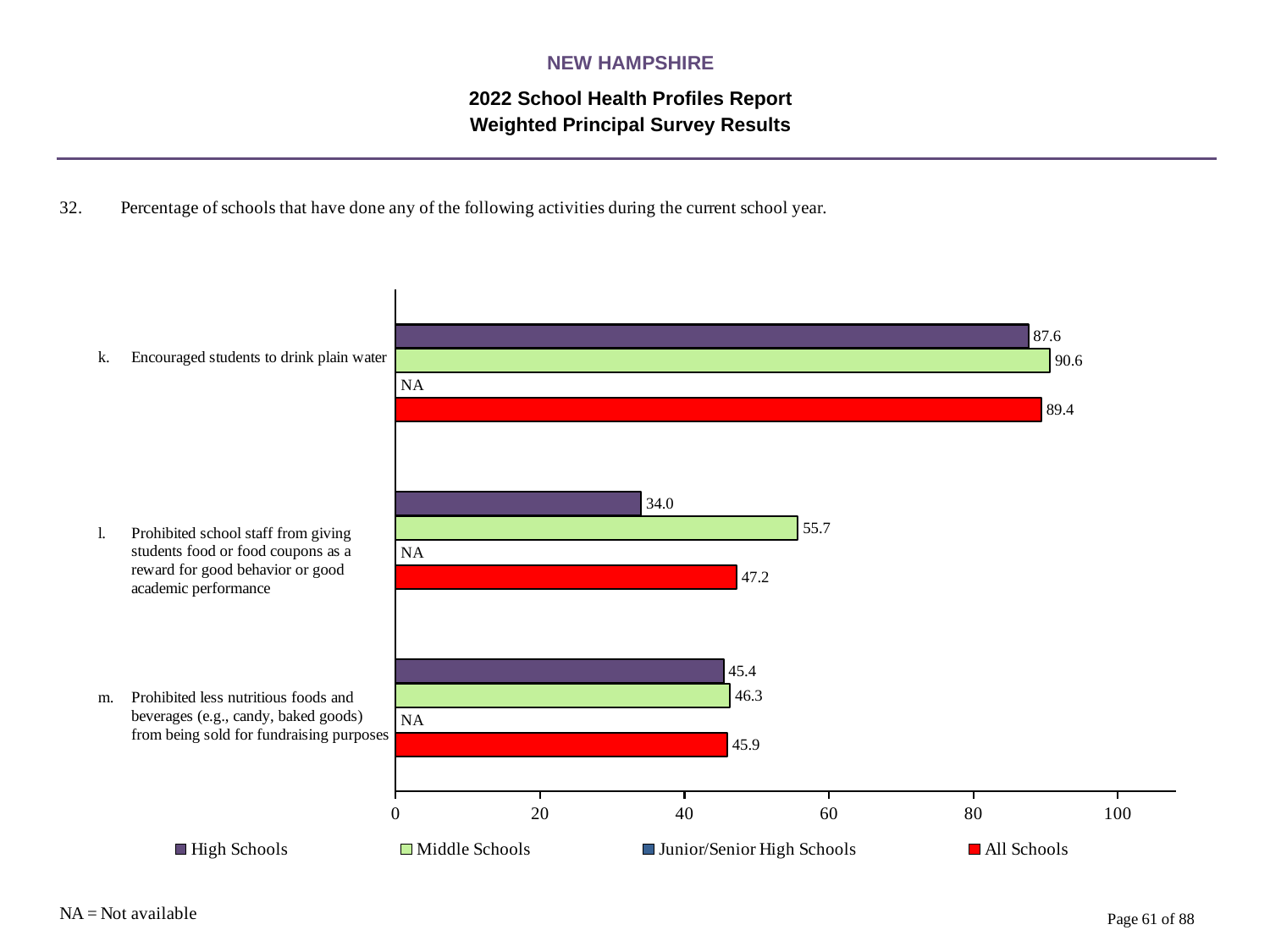
What is the value for All Schools for 'Prohibited less nutritious foods and beverages (e.g., candy, baked goods) from being sold for fundraising purposes'? 45.9 What is the value for High Schools for 'Encouraged students to drink plain water'? 87.6 Which activity has the highest value for Middle Schools? Encouraged students to drink plain water How many activities (categories) are shown on the chart? 3 What value is shown for Junior/Senior High Schools for 'Encouraged students to drink plain water'? NA How many series does the legend list? 4 Is the All Schools value for 'Prohibited school staff from giving students food or food coupons as a reward for good behavior or good academic performance' greater or less than 40? greater For 'Encouraged students to drink plain water', which is larger: the Middle Schools value or the All Schools value? Middle Schools What is the difference between the Middle Schools and High Schools values for 'Prohibited school staff from giving students food or food coupons as a reward for good behavior or good academic performance'? 21.7 Which activity has the lowest value for High Schools? Prohibited school staff from giving students food or food coupons as a reward for good behavior or good academic performance What is the value for Middle Schools for 'Prohibited school staff from giving students food or food coupons as a reward for good behavior or good academic performance'? 55.7 What kind of chart is shown on the slide? Bar chart